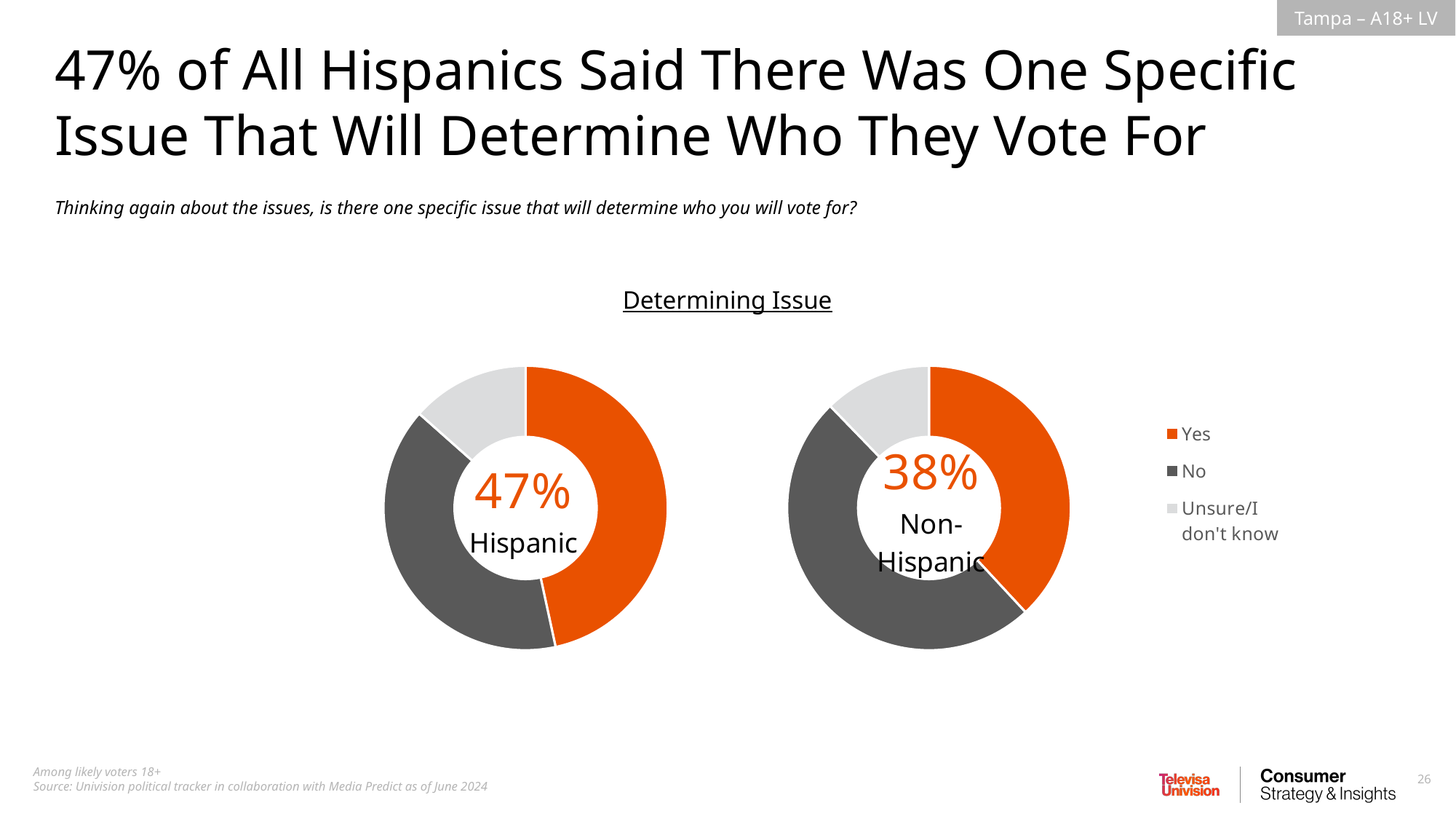
Which group has the larger Yes share, Hispanic or Non-Hispanic? Hispanic What is the title shown above the two donut charts? Determining Issue In the Hispanic donut chart, which response is the smallest slice? Unsure/I don't know What colour represents the Yes response in the donut charts? Orange What is the difference in percentage points between the Hispanic Yes share and the Non-Hispanic Yes share? 9 percentage points In the Non-Hispanic donut chart, what percentage said Yes? 38% How many response categories does the legend list for the Determining Issue charts? 3 In the Hispanic donut chart, what percentage said Yes, there is one specific issue that will determine who they vote for? 47% In the Non-Hispanic donut chart, which response is the largest slice? No In the Non-Hispanic donut chart, which response is the smallest slice? Unsure/I don't know How many donut charts are shown on the slide? 2 What kind of chart is used to show the Determining Issue results? Donut (pie) chart